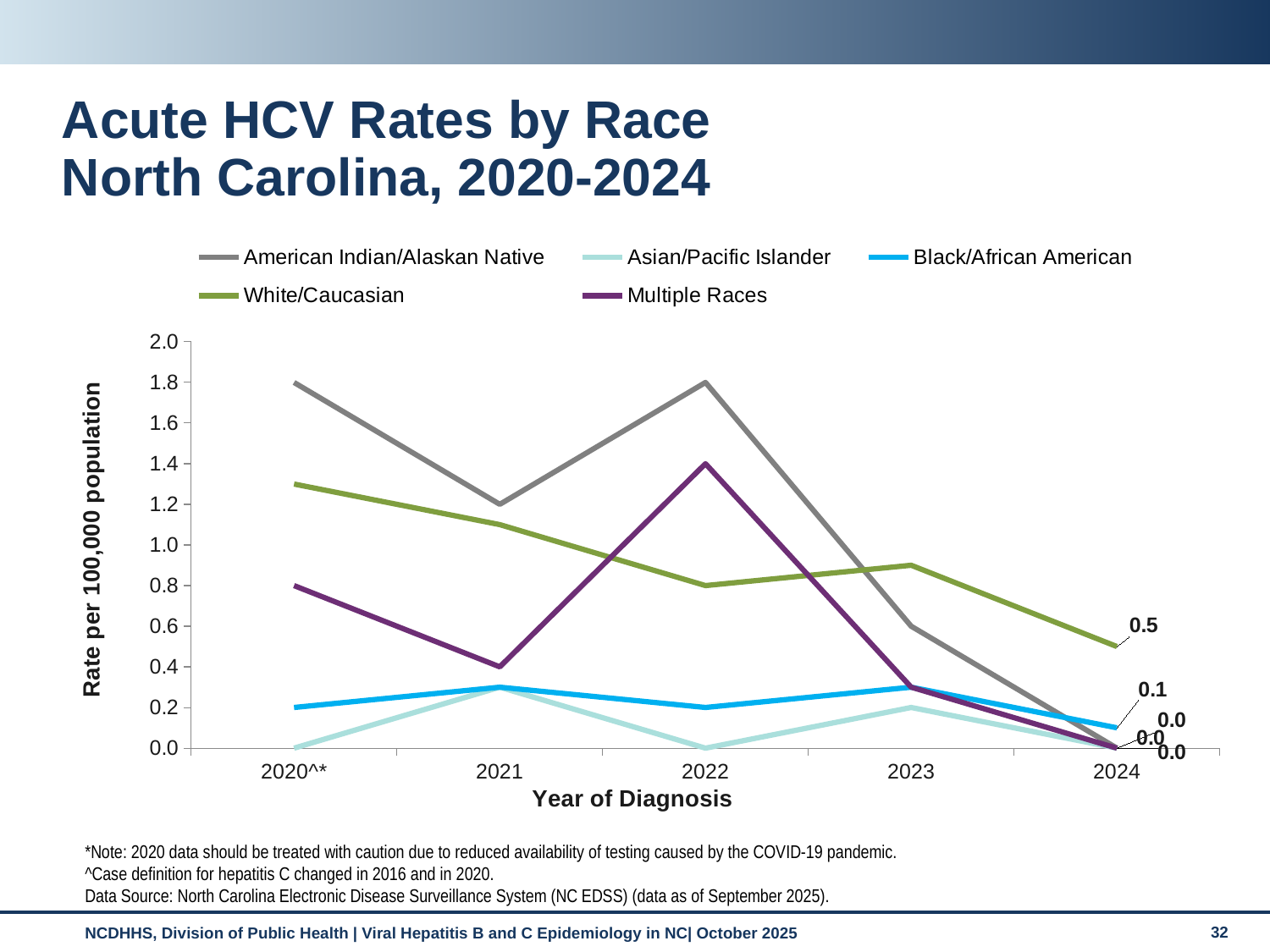
Is the rate for American Indian/Alaskan Native in 2021 greater or less than 1.0? greater What is the acute HCV rate for White/Caucasian in 2024? 0.5 Does the White/Caucasian rate rise or fall from 2020^* to 2024? fall Which race has the highest rate in 2022? American Indian/Alaskan Native In 2023, which is higher: the rate for White/Caucasian or for American Indian/Alaskan Native? White/Caucasian What is the label on the y axis? Rate per 100,000 population What is the rate for Multiple Races in 2022? 1.4 How many series does the legend list? 5 What type of chart is shown on the slide? Line chart What is the acute HCV rate for Black/African American in 2024? 0.1 How many years are shown on the x axis? 5 Which race has the lowest rate in 2020^*? Asian/Pacific Islander